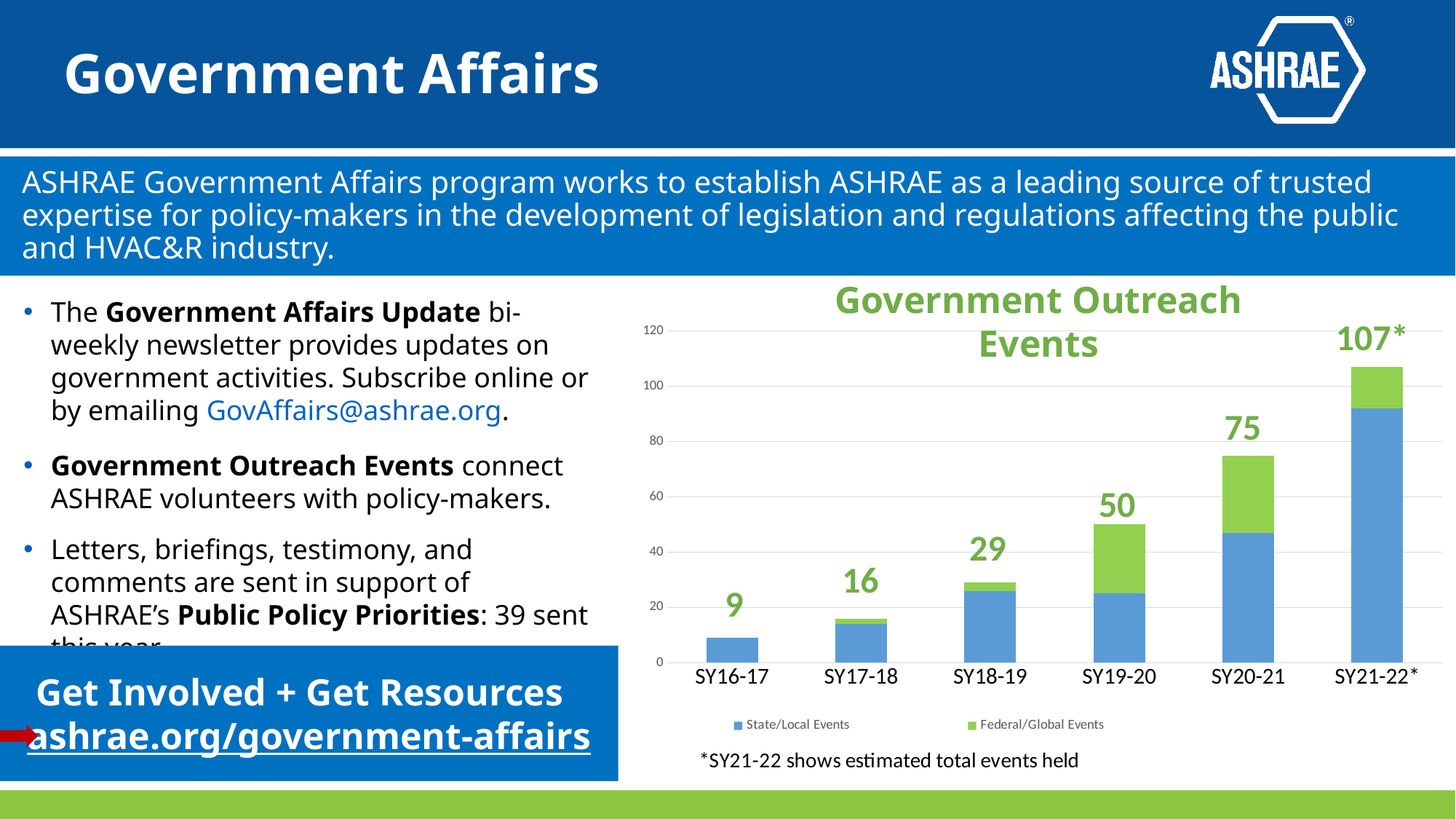
Do the total Government Outreach Events rise or fall from SY16-17 to SY21-22*? Rise What is the total number of Government Outreach Events labeled for SY19-20? 50 What is the total labeled above the SY21-22* bar? 107* Which society year has the highest total of Government Outreach Events? SY21-22* Which society year has the lowest total of Government Outreach Events? SY16-17 What is the difference between the labeled totals for SY20-21 and SY18-19? 46 Is the State/Local Events value for SY21-22* greater or less than 80? greater What type of chart is shown on the slide? Stacked bar chart What is the title of the chart? Government Outreach Events How many series does the chart legend list? 2 What is the total number of Government Outreach Events labeled for SY16-17? 9 How many society years (categories) are shown on the x axis of the chart? 6